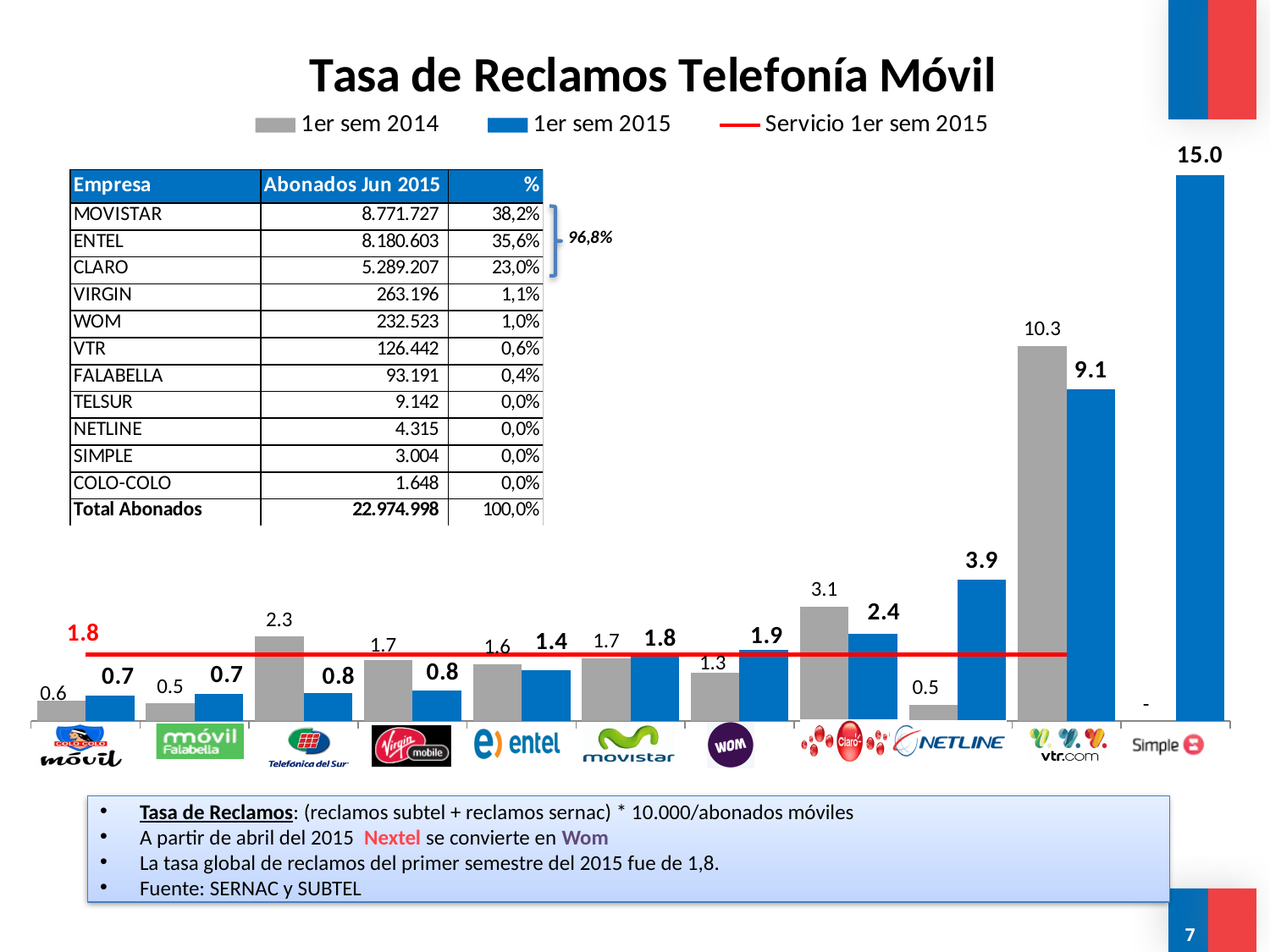
What is the 1er sem 2014 value for VTR? 10.3 Which company has the highest 1er sem 2014 value? VTR How many companies are shown on the x axis of the chart? 11 What is the 1er sem 2014 value for Telefónica del Sur? 2.3 Which company has the highest 1er sem 2015 value? Simple What colour are the 1er sem 2015 bars? Blue How many entries does the chart legend list? 3 What is the difference between VTR's 1er sem 2014 and 1er sem 2015 values? 1.2 What type of chart is shown on the slide? Combination bar and line chart What is the 1er sem 2015 value for Netline? 3.9 For Claro, which is larger: the 1er sem 2014 value or the 1er sem 2015 value? 1er sem 2014 What value does the red 'Servicio 1er sem 2015' line mark? 1.8